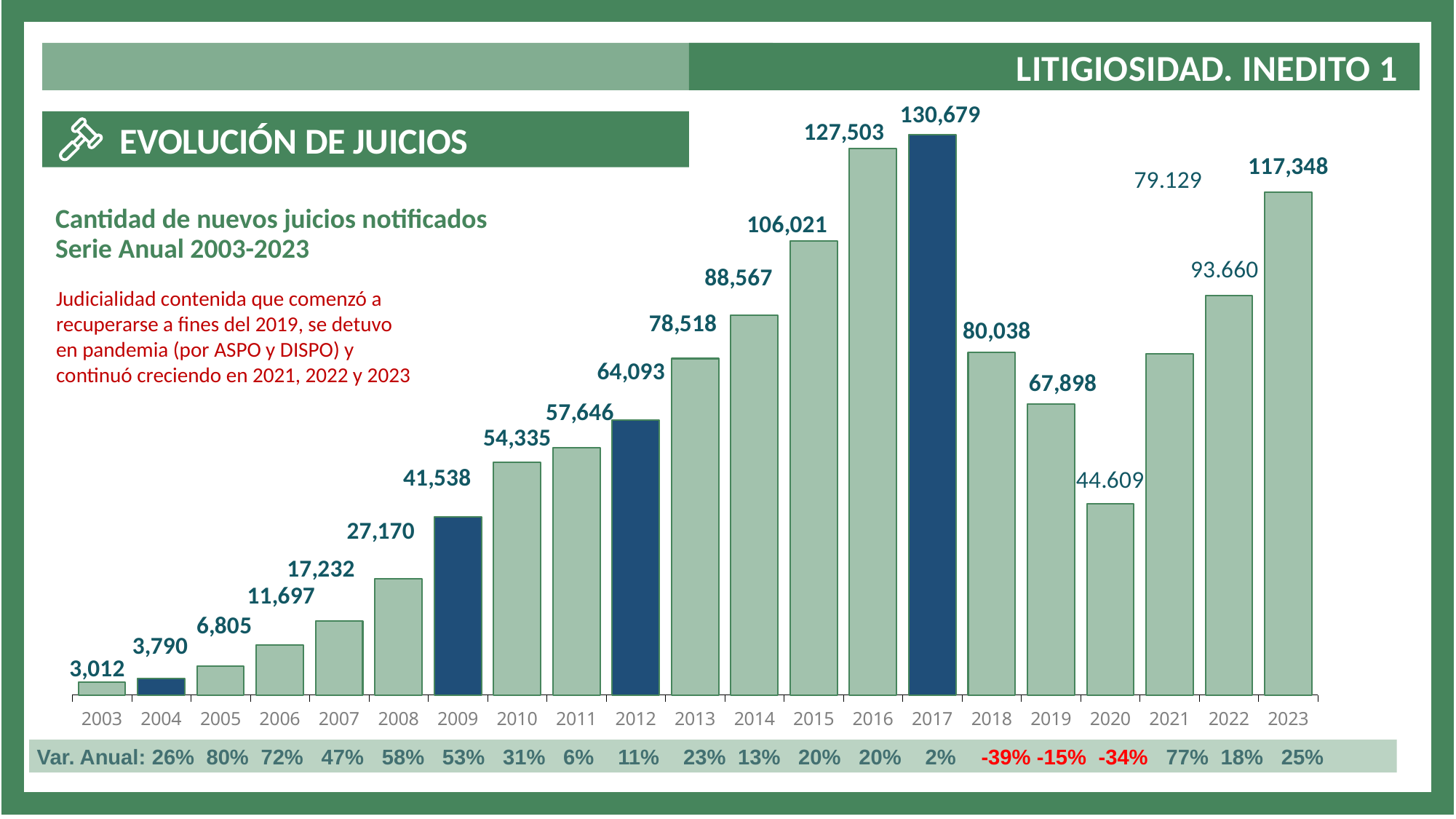
What is the value for 2017? 130,679 What is the 'Var. Anual' shown for 2020? -34% What is the difference between the values for 2017 and 2016? 3,176 How many years are plotted in the chart? 21 What is the value for 2009? 41,538 Which year has the highest value? 2017 Which is larger, the value for 2015 or the value for 2023? 2023 What kind of chart is shown? bar chart Do the values rise or fall from 2003 to 2017? rise Which year has the lowest value? 2003 What is the value for 2020? 44.609 What is the difference between the values for 2018 and 2019? 12,140